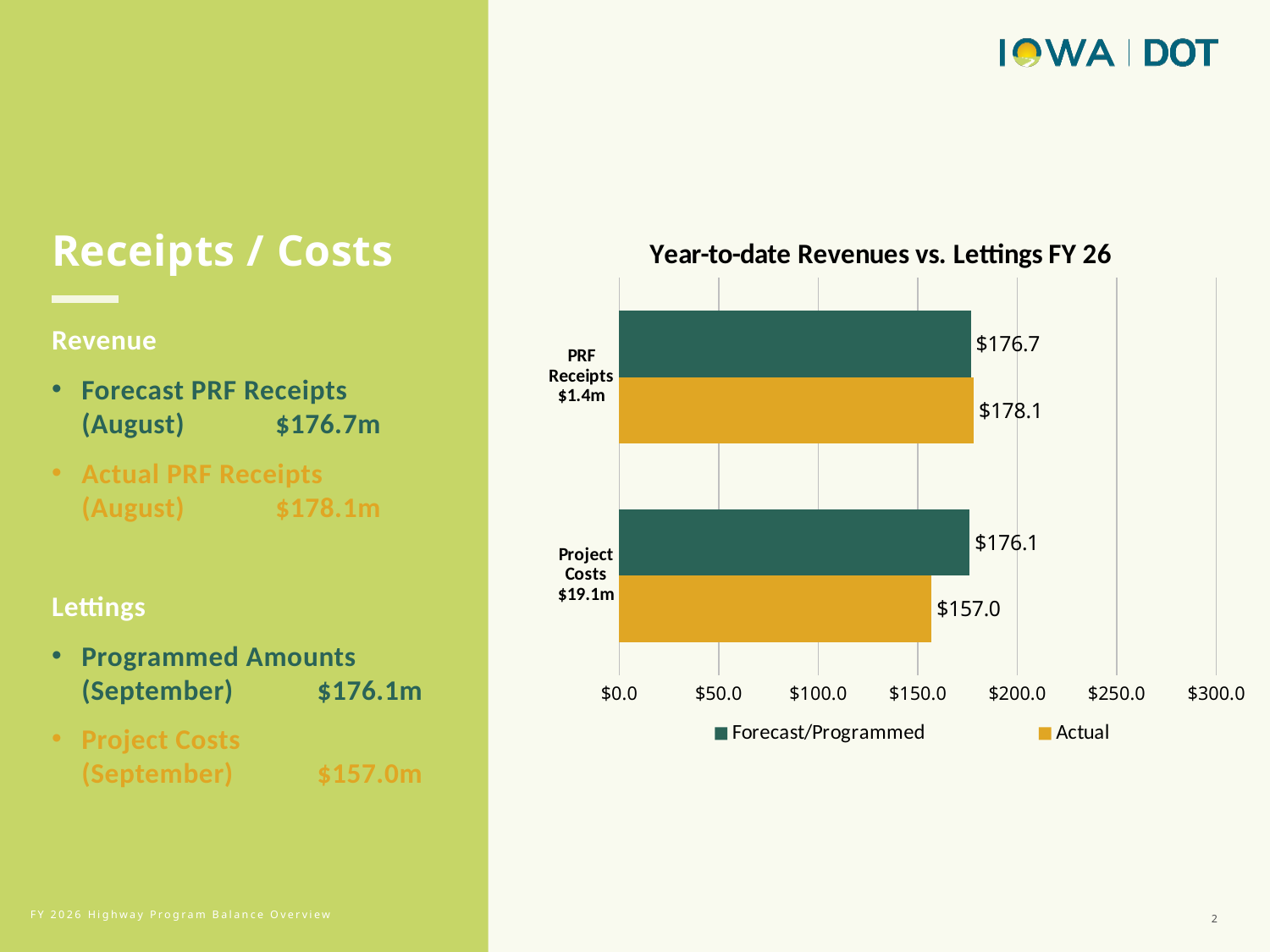
How many categories are shown on the chart? 2 What kind of chart is shown on the slide? Bar chart What is the difference between the Forecast/Programmed and Actual values for Project Costs? $19.1 Which is larger for Project Costs, the Forecast/Programmed value or the Actual value? Forecast/Programmed What is the Actual value for PRF Receipts? $178.1 What is the Forecast/Programmed value for Project Costs? $176.1 Is the Actual value for Project Costs greater or less than $150.0? greater What is the title of the chart? Year-to-date Revenues vs. Lettings FY 26 What is the Forecast/Programmed value for PRF Receipts? $176.7 What is the Actual value for Project Costs? $157.0 How many series does the chart legend list? 2 What is the difference between the Actual and Forecast/Programmed values for PRF Receipts? $1.4